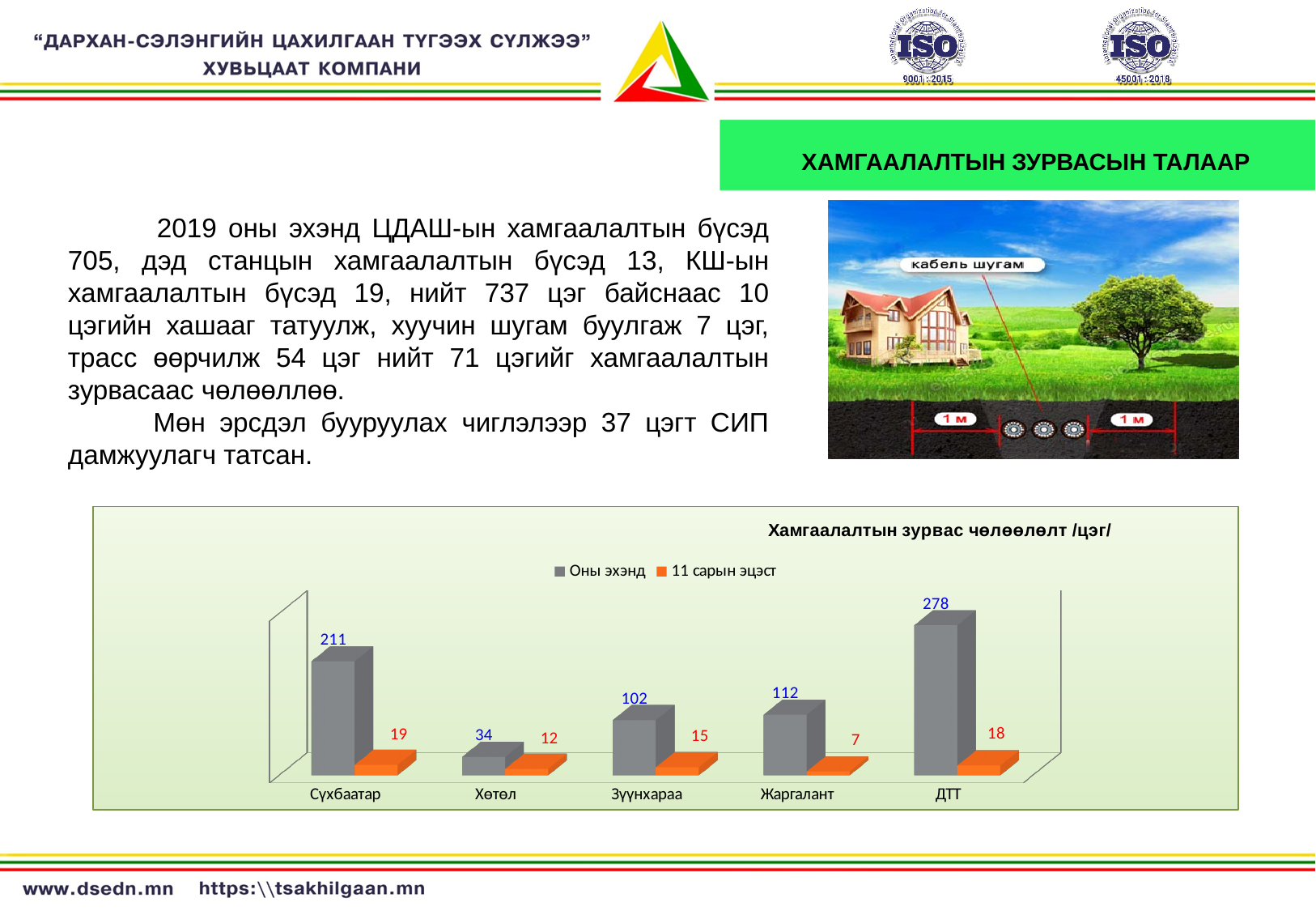
Which category has the highest value in the "Оны эхэнд" series? ДТТ What is the value for Сүхбаатар in the "Оны эхэнд" series? 211 What is the difference between the "Оны эхэнд" values for ДТТ and Сүхбаатар? 67 How many categories are shown on the x axis of the chart? 5 Which category has the lowest value in the "11 сарын эцэст" series? Жаргалант Which category has the lowest value in the "Оны эхэнд" series? Хөтөл How many series does the chart legend list? 2 What is the difference between the "Оны эхэнд" and "11 сарын эцэст" values for Зүүнхараа? 87 What is the value for Жаргалант in the "11 сарын эцэст" series? 7 What type of chart is shown on the slide? Bar chart What is the value for ДТТ in the "Оны эхэнд" series? 278 Which is larger in the "11 сарын эцэст" series: Сүхбаатар or Хөтөл? Сүхбаатар